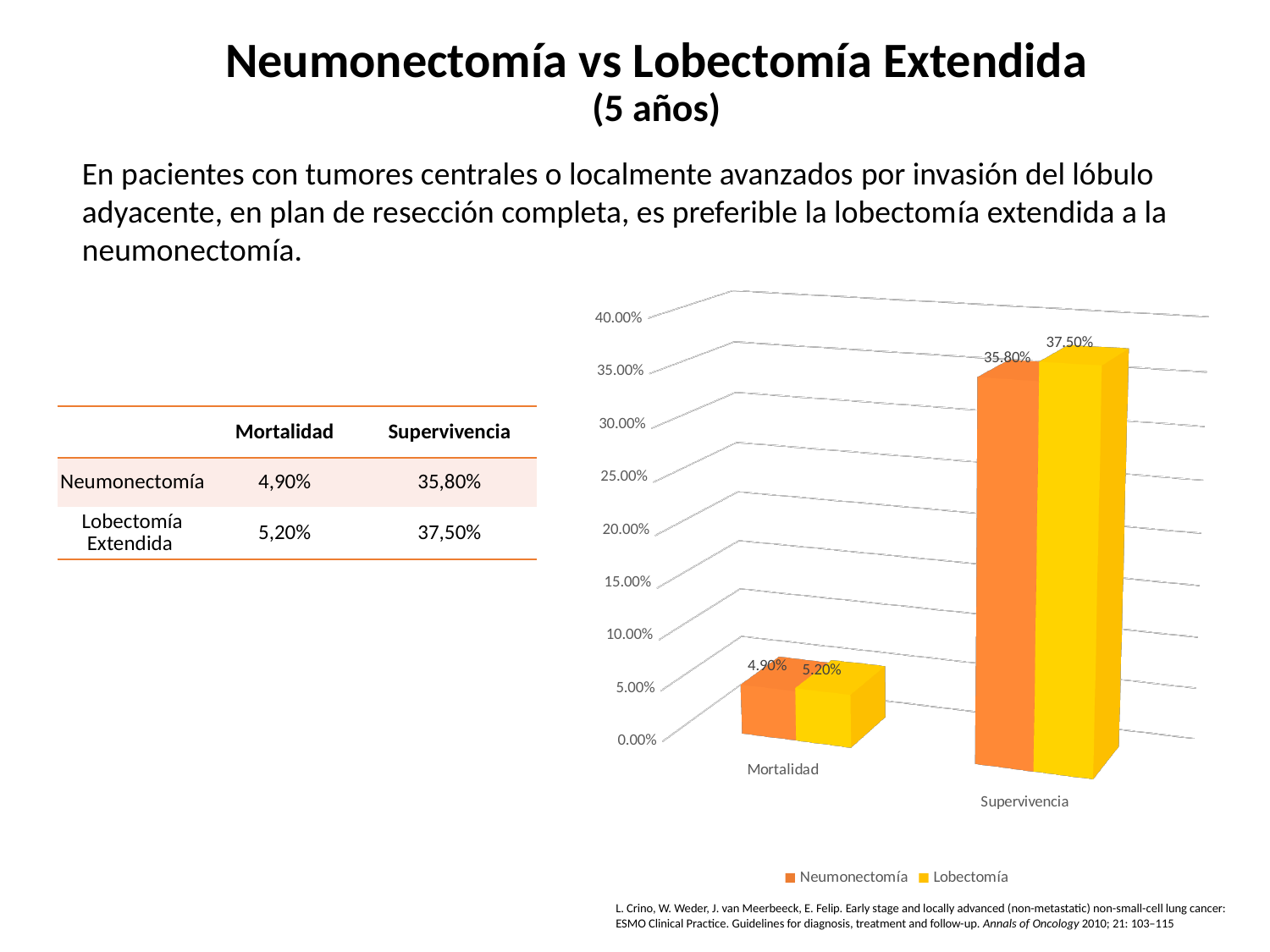
What is the value for Lobectomía in the Mortalidad category? 5.20% What is the value for Neumonectomía in the Supervivencia category? 35.80% Which colour represents the Lobectomía series in the chart? Yellow Which series has the higher value in the Supervivencia category? Lobectomía What is the difference between the Lobectomía and Neumonectomía values in the Supervivencia category? 1.70% What is the difference between the Lobectomía and Neumonectomía values in the Mortalidad category? 0.30% What kind of chart is shown on the slide? Bar chart How many series does the chart legend list? 2 What is the value for Lobectomía in the Supervivencia category? 37.50% How many categories are shown on the x axis of the chart? 2 Is the Neumonectomía value for Supervivencia greater or less than 30.00%? greater What is the value for Neumonectomía in the Mortalidad category? 4.90%